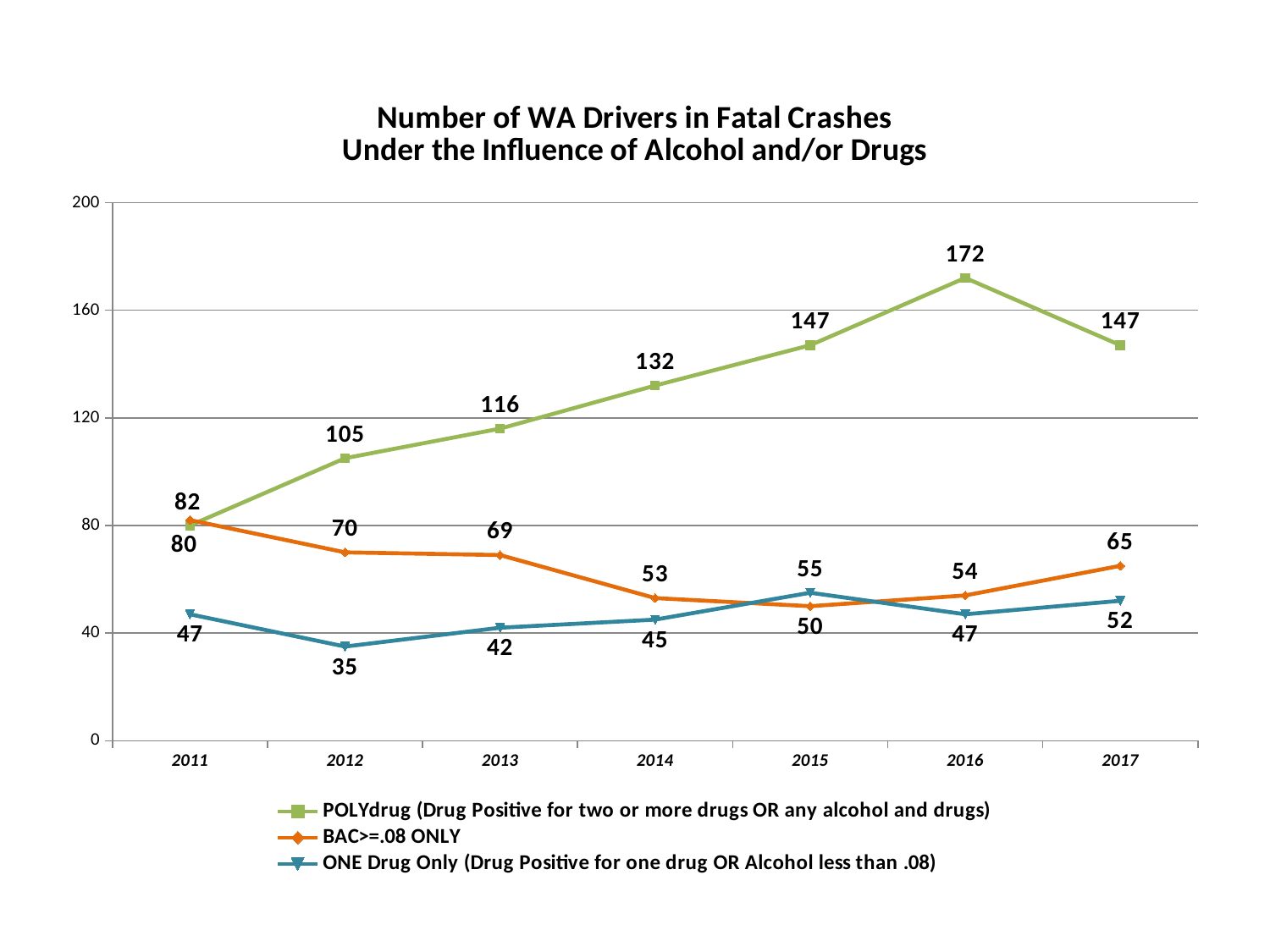
In which year is the ONE Drug Only series lowest? 2012 What is the POLYdrug value for 2016? 172 How many years are plotted along the x axis? 7 How many series does the legend list? 3 What is the title of the chart? Number of WA Drivers in Fatal Crashes Under the Influence of Alcohol and/or Drugs What is the ONE Drug Only value for 2012? 35 In which year is the POLYdrug series highest? 2016 What is the difference between the POLYdrug value in 2016 and in 2017? 25 Does the BAC>=.08 ONLY series generally rise or fall from 2011 to 2015? Fall In 2015, which series has the larger value: BAC>=.08 ONLY or ONE Drug Only? ONE Drug Only What is the BAC>=.08 ONLY value for 2014? 53 What type of chart is shown on the slide? Line chart